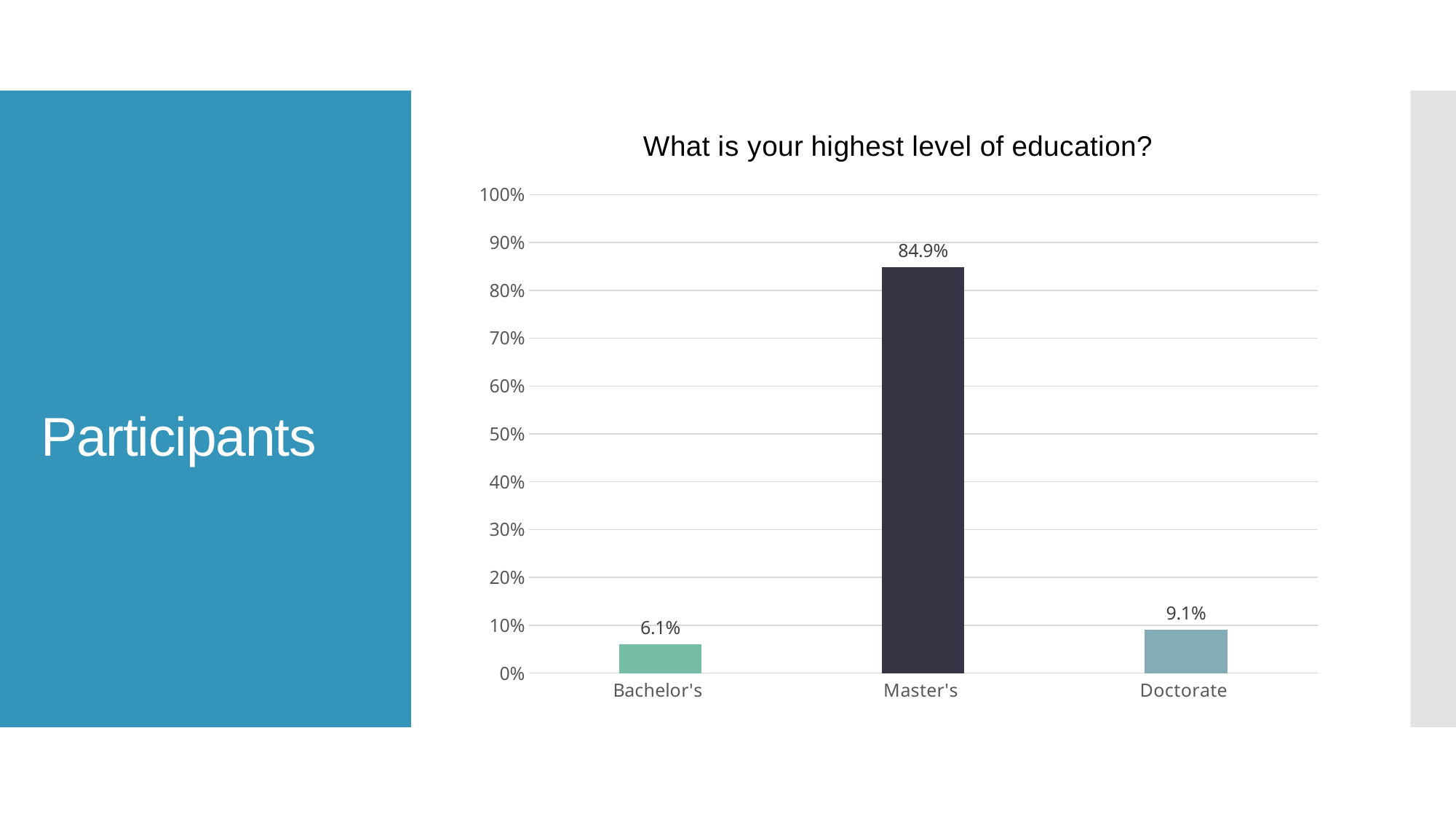
Which education level has the lowest percentage of participants? Bachelor's What is the difference in percentage points between Doctorate and Bachelor's? 3.0 How many education levels are shown on the chart? 3 What percentage of participants have a Bachelor's as their highest level of education? 6.1% What kind of chart is shown on the slide? Bar chart What percentage of participants have a Master's as their highest level of education? 84.9% Which education level has the highest percentage of participants? Master's What is the title of the chart? What is your highest level of education? What is the difference in percentage points between Master's and Doctorate? 75.8 Which is larger, the percentage for Doctorate or for Bachelor's? Doctorate What percentage of participants have a Doctorate as their highest level of education? 9.1% Is the value for Master's greater or less than 80%? greater